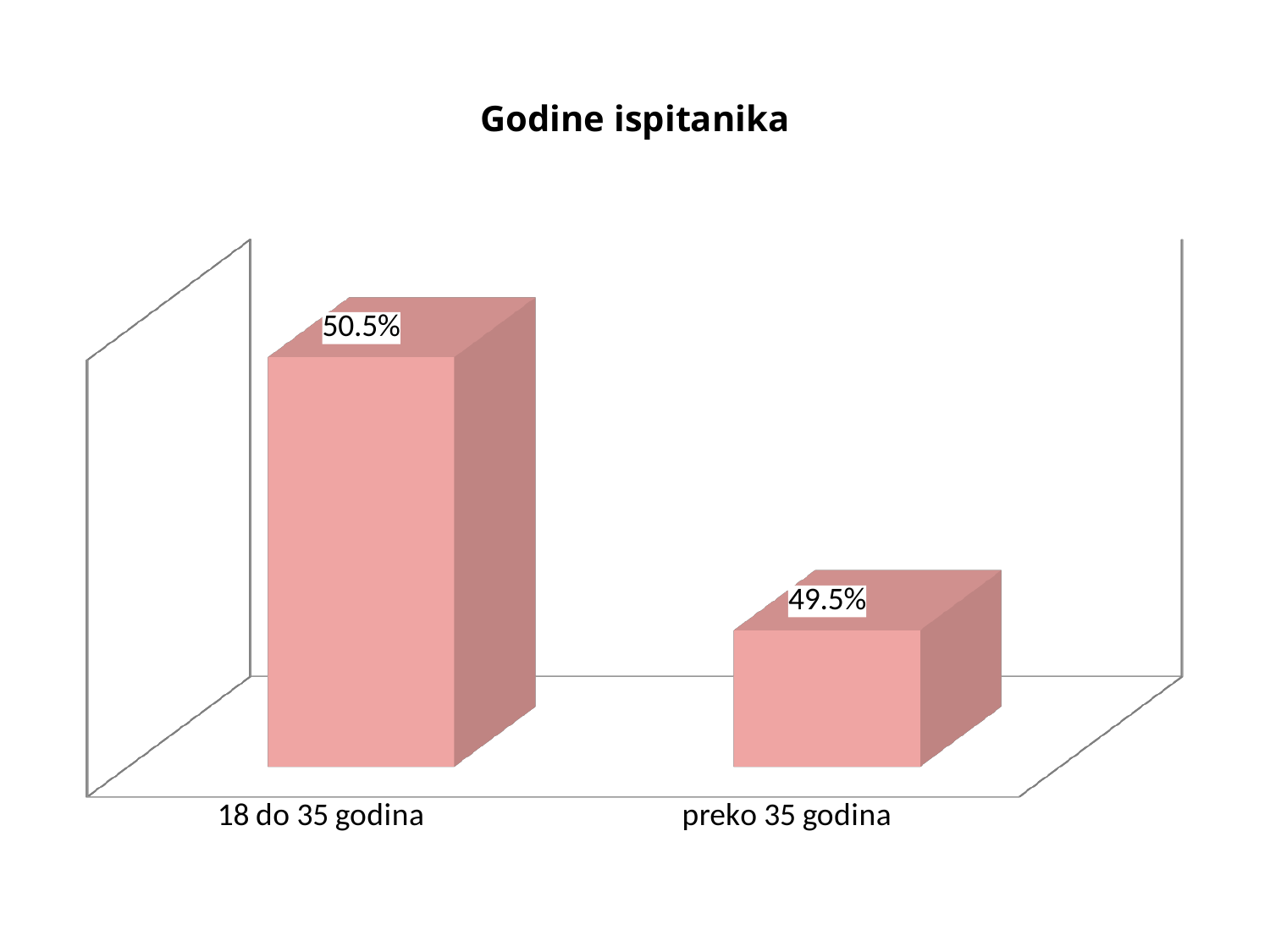
Which is larger, the value for "18 do 35 godina" or the value for "preko 35 godina"? 18 do 35 godina What is the value for "preko 35 godina"? 49.5% Do the values rise or fall from left to right along the x axis? Fall What colour are the bars in the chart? Pink What is the title of the chart? Godine ispitanika What is the total of the two values shown in the chart? 100.0% Which category has the highest value? 18 do 35 godina What is the difference between the values for "18 do 35 godina" and "preko 35 godina"? 1.0% Which category has the lowest value? preko 35 godina What kind of chart is shown on the slide? Bar chart What is the value for "18 do 35 godina"? 50.5% How many categories are shown in the chart? 2